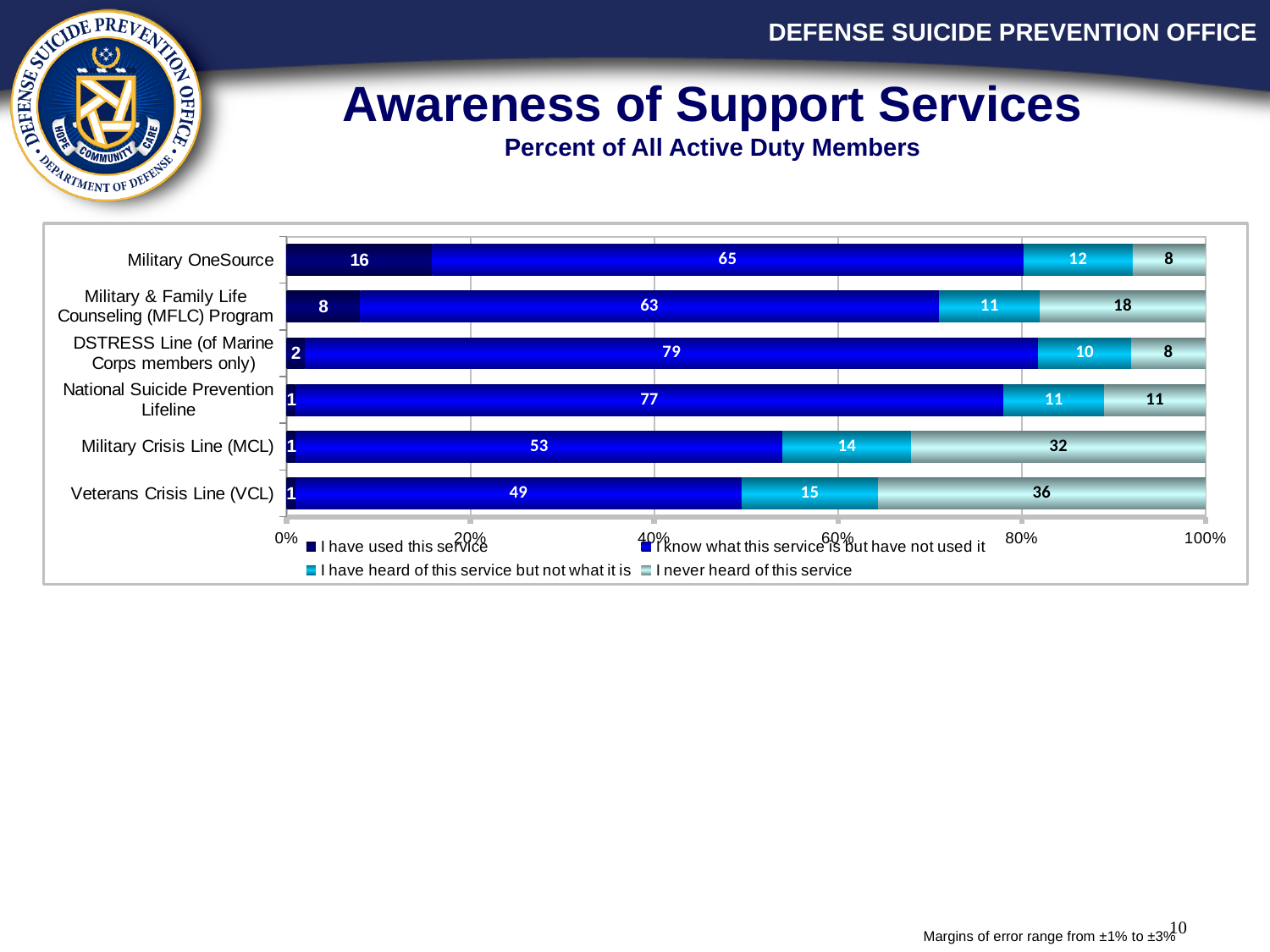
What is the value for 'I never heard of this service' for the Veterans Crisis Line (VCL)? 36 What percentage of active duty members have used Military OneSource? 16 What kind of chart is shown on the slide? Stacked bar chart Which has a larger 'I have used this service' value: Military OneSource or the Military & Family Life Counseling (MFLC) Program? Military OneSource What is the difference between the 'I never heard of this service' values for the Veterans Crisis Line (VCL) and the Military Crisis Line (MCL)? 4 How many support services are shown on the chart? 6 Which service has the highest value for 'I have used this service'? Military OneSource What is the value for 'I have heard of this service but not what it is' for the Military Crisis Line (MCL)? 14 Which service has the highest value for 'I know what this service is but have not used it'? DSTRESS Line (of Marine Corps members only) How many series does the legend list? 4 What is the total of the stacked bar for the Military & Family Life Counseling (MFLC) Program? 100 Which service has the highest value for 'I never heard of this service'? Veterans Crisis Line (VCL)